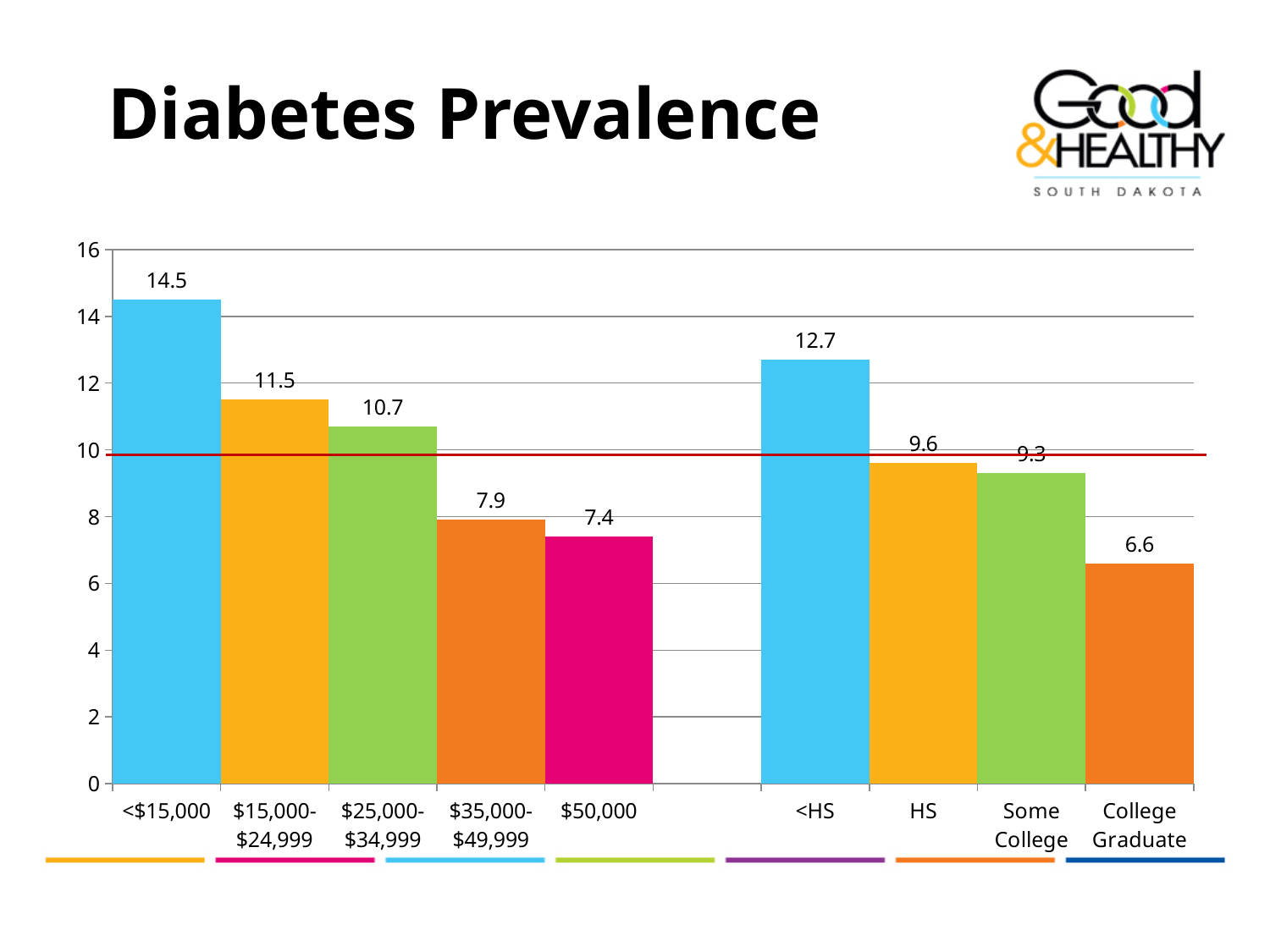
Which category has the lowest value on the chart? College Graduate What kind of chart is shown on the slide? bar chart How many bars are plotted on the chart? 9 What is the value shown for College Graduate? 6.6 What is the title of the slide? Diabetes Prevalence Is the value for Some College greater or less than 10? less What is the value shown for the $35,000-$49,999 income category? 7.9 What is the difference between the values for <HS and College Graduate? 6.1 What is the difference between the values for <$15,000 and $50,000? 7.1 Which is larger, the value for $25,000-$34,999 or the value for HS? $25,000-$34,999 Which category has the highest value on the chart? <$15,000 What is the diabetes prevalence value for the <$15,000 income category? 14.5